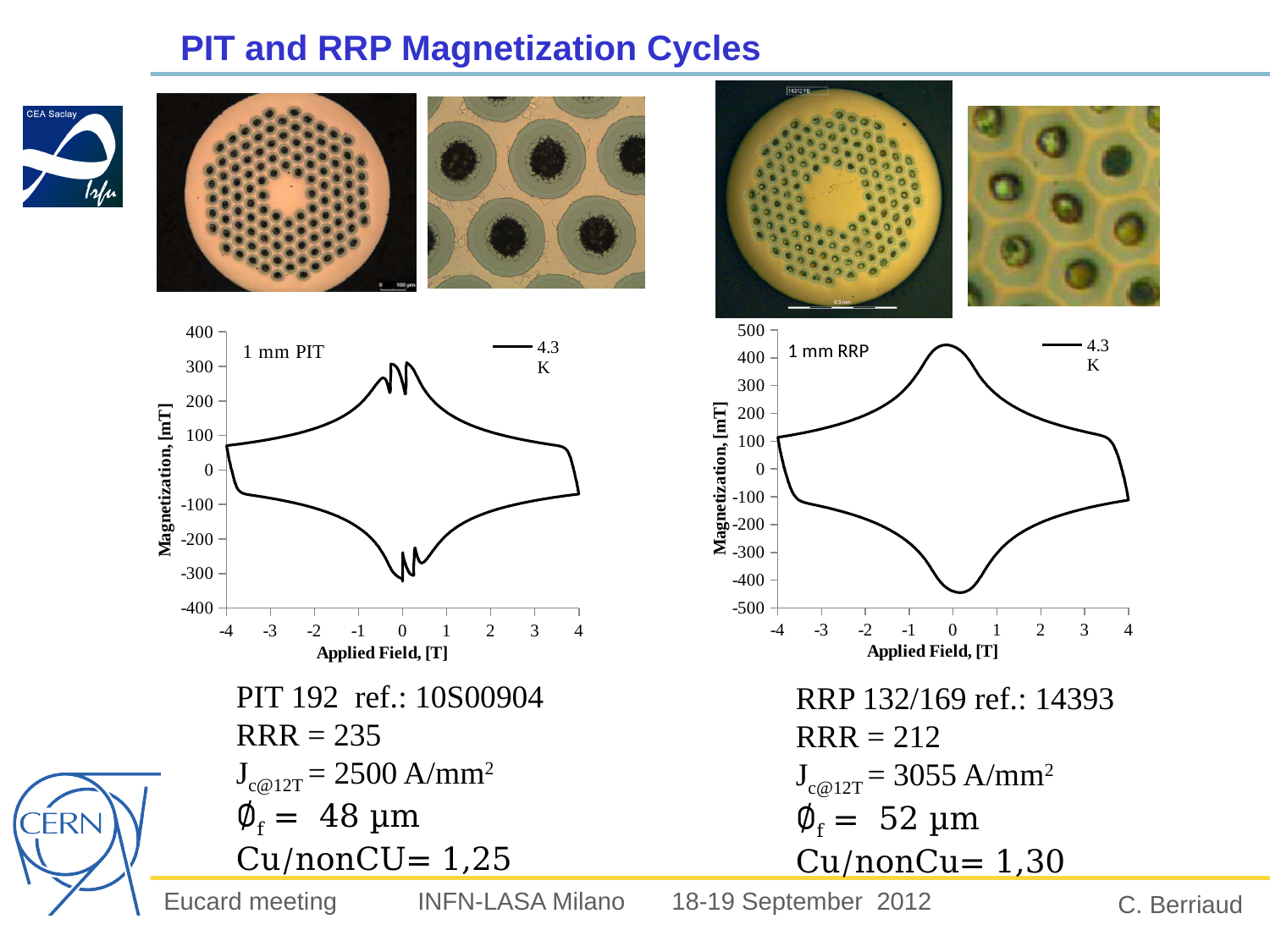
In the '1 mm PIT' chart, is the magnetization on the upper branch at an applied field of 4 T greater or less than 100? less In the '1 mm PIT' chart, is the peak magnetization near 0 T applied field greater or less than 200? greater In the '1 mm RRP' chart, does the magnetization on the upper branch rise or fall as the applied field increases from -4 T to 0 T? rise What is the x-axis label of the '1 mm PIT' chart? Applied Field, [T] In the '1 mm PIT' chart, does the magnetization on the upper branch rise or fall as the applied field increases from 0 T to 4 T? fall In the '1 mm RRP' chart, is the lowest magnetization value on the lower branch near 0 T greater or less than -400? less What kind of chart is the '1 mm PIT' chart on the left? line chart How many series does the legend of the '1 mm PIT' chart list? 1 What kind of chart is the '1 mm RRP' chart on the right? line chart What is the legend entry shown on the '1 mm RRP' chart? 4.3 K